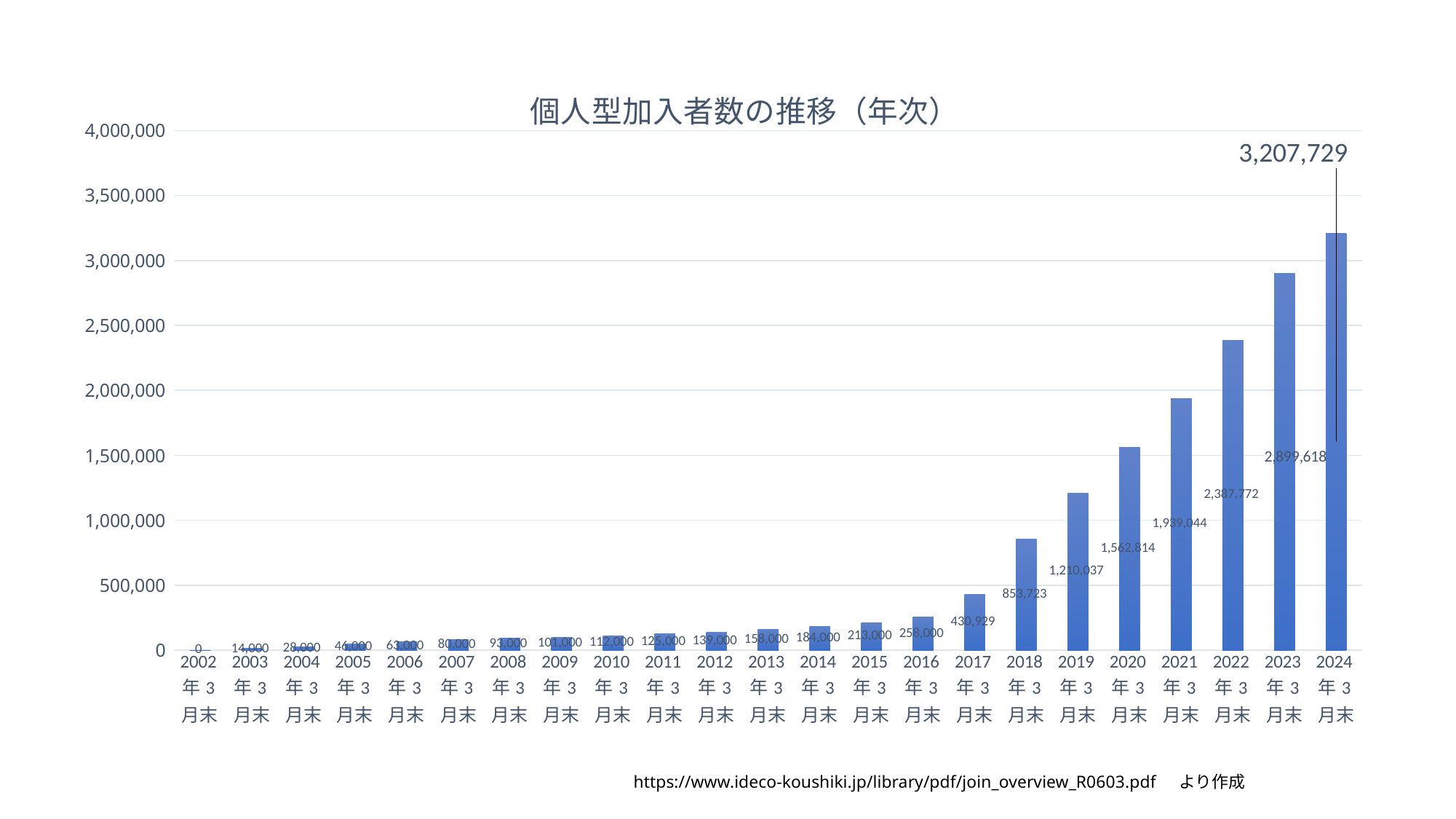
How many years (categories) are shown on the x axis? 23 What is the value for 2017年3月末? 430,929 What is the title of the chart? 個人型加入者数の推移（年次） What is the value for 2019年3月末? 1,210,037 Which is larger, the value for 2021年3月末 or the value for 2020年3月末? 2021年3月末 What is the value for 2024年3月末? 3,207,729 What type of chart is shown on the slide? bar chart What is the difference between the values for 2024年3月末 and 2023年3月末? 308,111 Which year has the highest value? 2024年3月末 What is the value for 2023年3月末? 2,899,618 Do the values rise or fall from 2002 to 2024 along the x axis? rise Which year has the lowest value? 2002年3月末